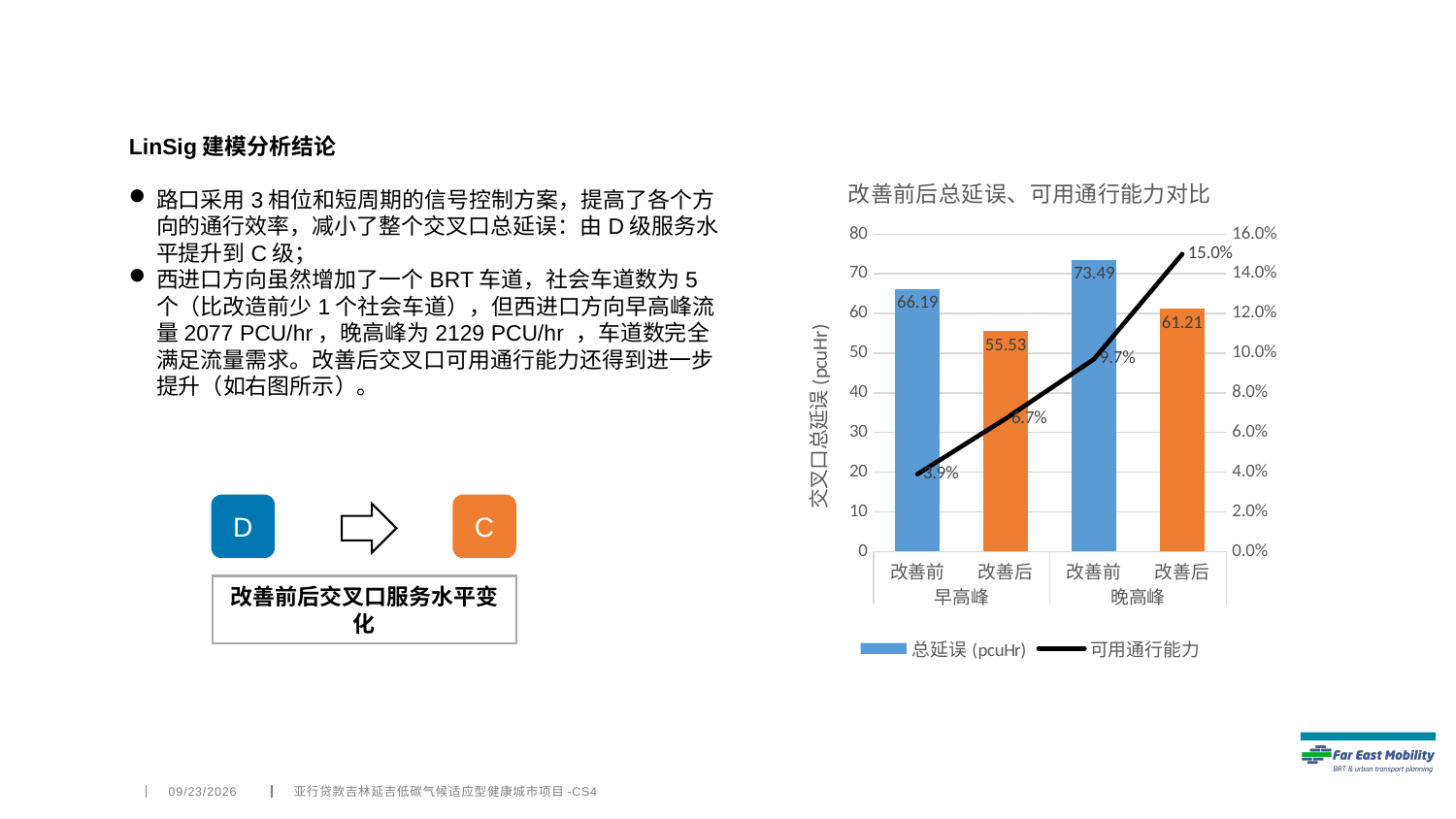
What is the difference in total delay between 改善前 and 改善后 in the 晚高峰 group? 12.28 How many bars are plotted in the chart? 4 How many series does the legend list? 2 Does the 可用通行能力 line rise or fall from left to right across the categories? rise What is the 可用通行能力 percentage for 改善后 in the 晚高峰 group? 15.0% Which is larger: the total delay for 改善后 早高峰 or 改善后 晚高峰? 改善后 晚高峰 What is the total delay (总延误) value for 改善后 in the 晚高峰 group? 61.21 What is the 可用通行能力 percentage for 改善前 in the 早高峰 group? 3.9% What is the difference in total delay between 改善前 and 改善后 in the 早高峰 group? 10.66 Which bar has the lowest total delay (总延误)? 改善后 早高峰 (55.53) Which bar has the highest total delay (总延误)? 改善前 晚高峰 (73.49) What is the total delay (总延误) value for 改善前 in the 早高峰 group? 66.19